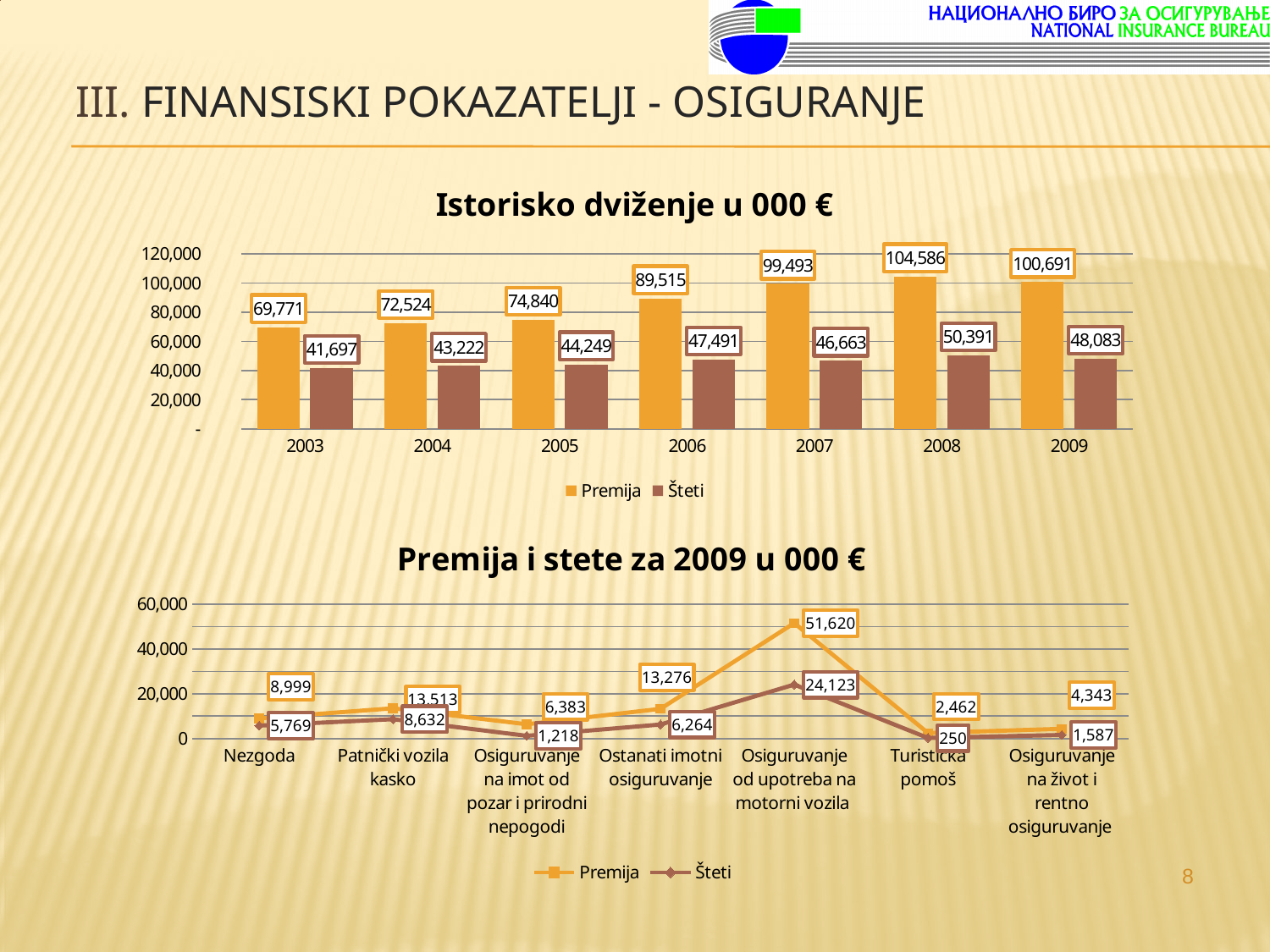
In the chart titled "Premija i stete za 2009 u 000 €", which category has the highest Šteti value? Osiguruvanje od upotreba na motorni vozila In the chart titled "Premija i stete za 2009 u 000 €", what is the Premija value for Osiguruvanje od upotreba na motorni vozila? 51,620 In the chart titled "Premija i stete za 2009 u 000 €", what is the Šteti value for Turisticka pomoš? 250 What kind of chart is the one titled "Istorisko dviženje u 000 €"? Bar chart In the chart titled "Istorisko dviženje u 000 €", how many years are shown on the x axis? 7 In the chart titled "Istorisko dviženje u 000 €", what is the difference between the Premija and Šteti values for 2009? 52,608 In the chart titled "Istorisko dviženje u 000 €", which year has the highest Premija value? 2008 In the chart titled "Istorisko dviženje u 000 €", what is the Šteti value for 2005? 44,249 How many series does the legend of the chart titled "Premija i stete za 2009 u 000 €" list? 2 In the chart titled "Istorisko dviženje u 000 €", what is the Premija value for 2008? 104,586 In the chart titled "Premija i stete za 2009 u 000 €", is the Premija value for Nezgoda larger or the Premija value for Patnički vozila kasko? Patnički vozila kasko In the chart titled "Istorisko dviženje u 000 €", which year has the lowest Šteti value? 2003